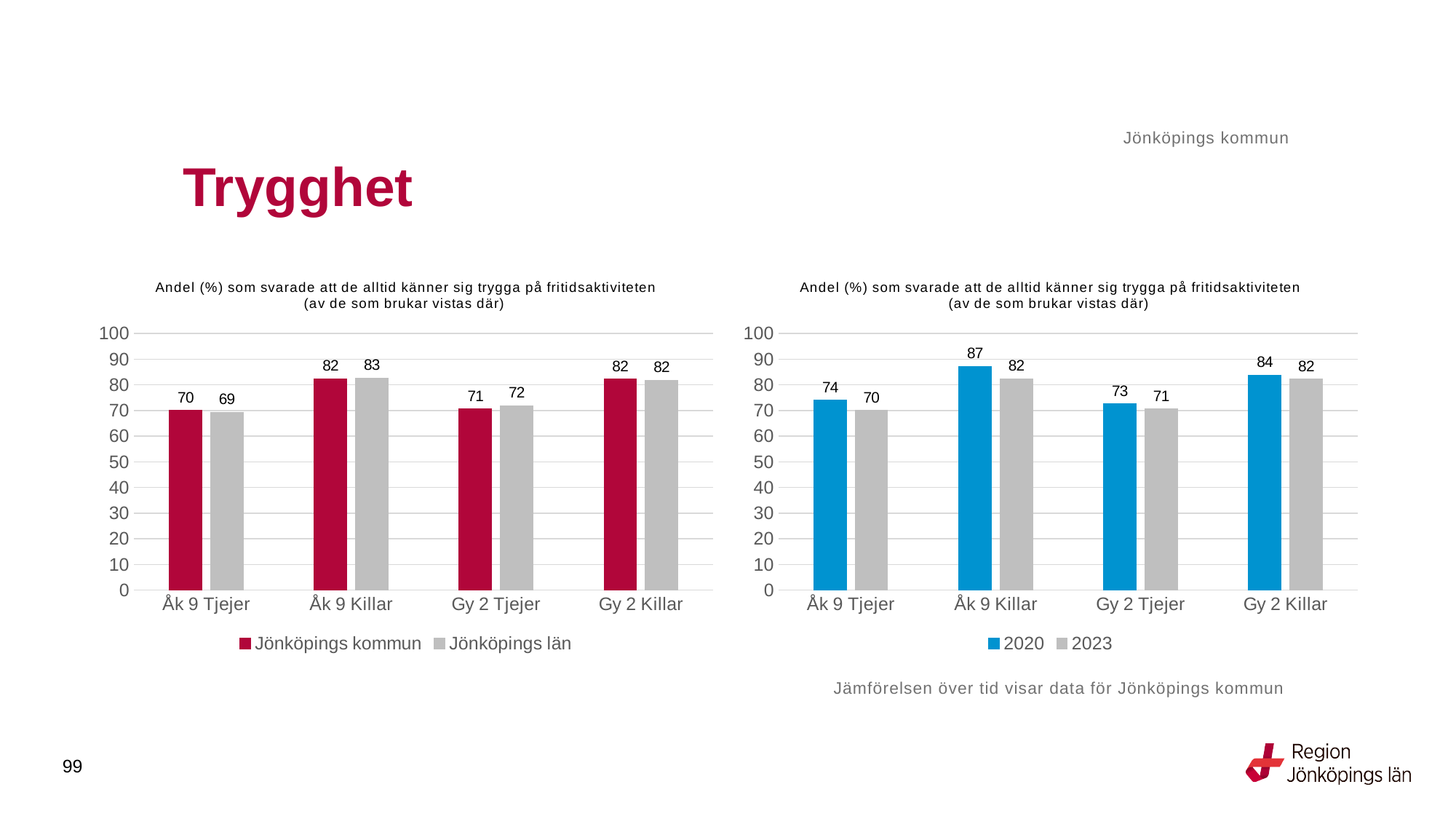
In the left chart, what is the value for Jönköpings kommun for Åk 9 Tjejer? 70 In the right chart, what is the difference between the 2020 and 2023 values for Åk 9 Killar? 5 How many categories are shown on the x axis of the left chart? 4 In the right chart, what is the difference between the 2020 and 2023 values for Åk 9 Tjejer? 4 In the right chart, what is the 2020 value for Åk 9 Killar? 87 In the right chart, what is the 2023 value for Gy 2 Tjejer? 71 How many series does the legend of the right chart list? 2 In the right chart, is the 2020 value for Gy 2 Killar larger or smaller than the 2023 value? larger In the left chart, what is the value for Jönköpings län for Åk 9 Killar? 83 In the left chart, which category has the lowest Jönköpings län value? Åk 9 Tjejer What type of chart is the left chart? bar chart In the right chart, which category has the highest 2020 value? Åk 9 Killar